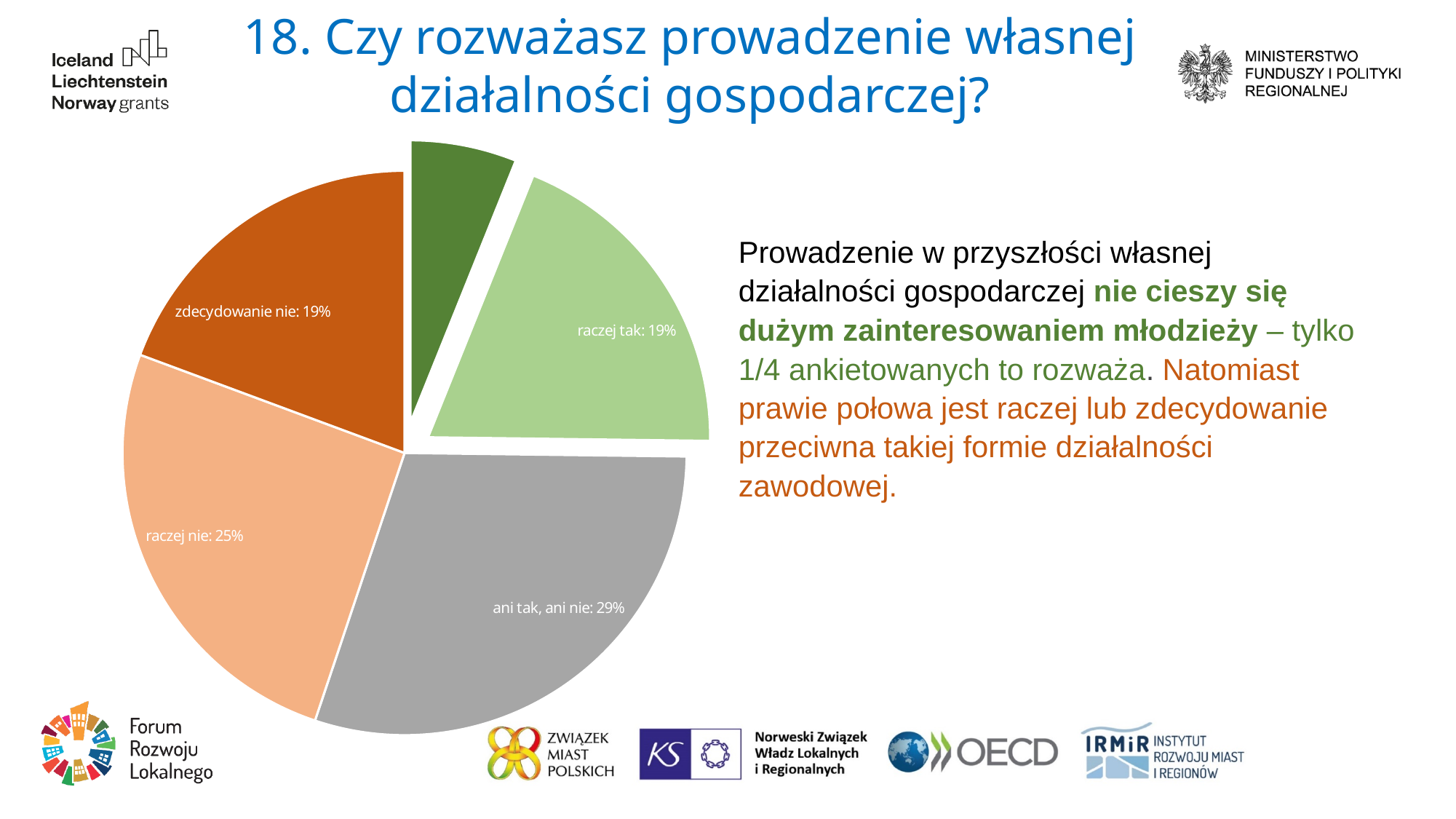
What is the difference in percentage points between "raczej nie" and "zdecydowanie nie"? 6 How many slices does the pie chart have? 5 What value is shown for the "zdecydowanie nie" slice? 19% What colour is the "ani tak, ani nie" slice of the pie chart? grey By how many percentage points does "ani tak, ani nie" exceed "raczej nie"? 4 Which is larger: the share for "raczej nie" or the share for "raczej tak"? raczej nie Which labelled slice of the pie chart has the largest share? ani tak, ani nie What value is shown for the "raczej tak" slice? 19% What share of the pie chart is labelled "ani tak, ani nie"? 29% What percentage of respondents answered "raczej nie" in the pie chart? 25% What is the combined share of "raczej nie" and "zdecydowanie nie"? 44% What type of chart is shown on the slide? pie chart